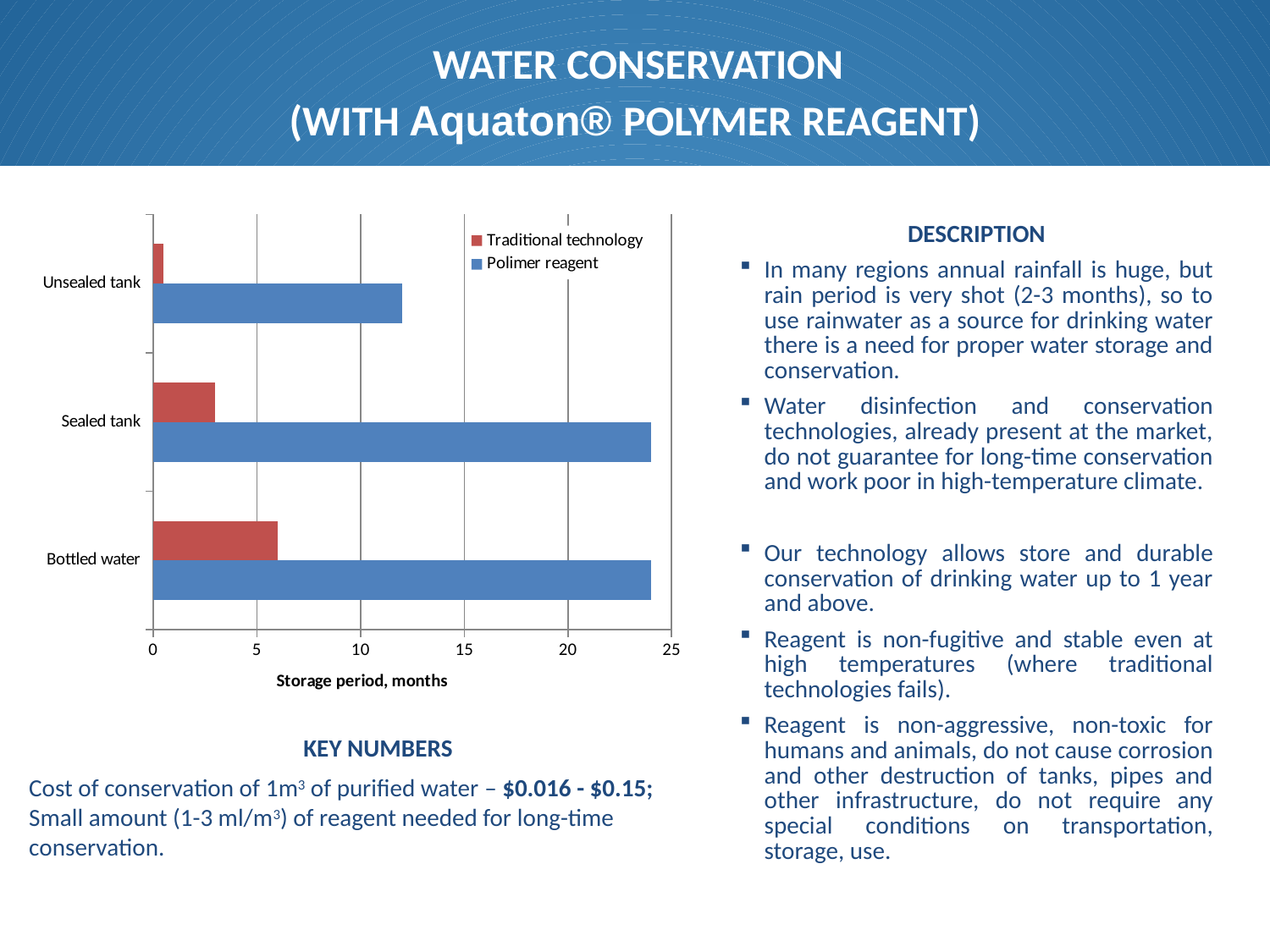
Is the Polimer reagent storage period for Sealed tank greater or less than 20 months? greater Which category has the lowest storage period for the Traditional technology series? Unsealed tank Is the Polimer reagent storage period for Unsealed tank greater or less than 10 months? greater For Sealed tank, which series has the longer storage period: Traditional technology or Polimer reagent? Polimer reagent What is the label of the chart's horizontal axis? Storage period, months How many categories are shown on the chart's vertical axis? 3 Which category has the highest storage period for the Traditional technology series? Bottled water How many series does the chart legend list? 2 Is the Traditional technology storage period for Sealed tank greater or less than 5 months? less What kind of chart is shown on the slide? bar chart Which category has the lowest storage period for the Polimer reagent series? Unsealed tank